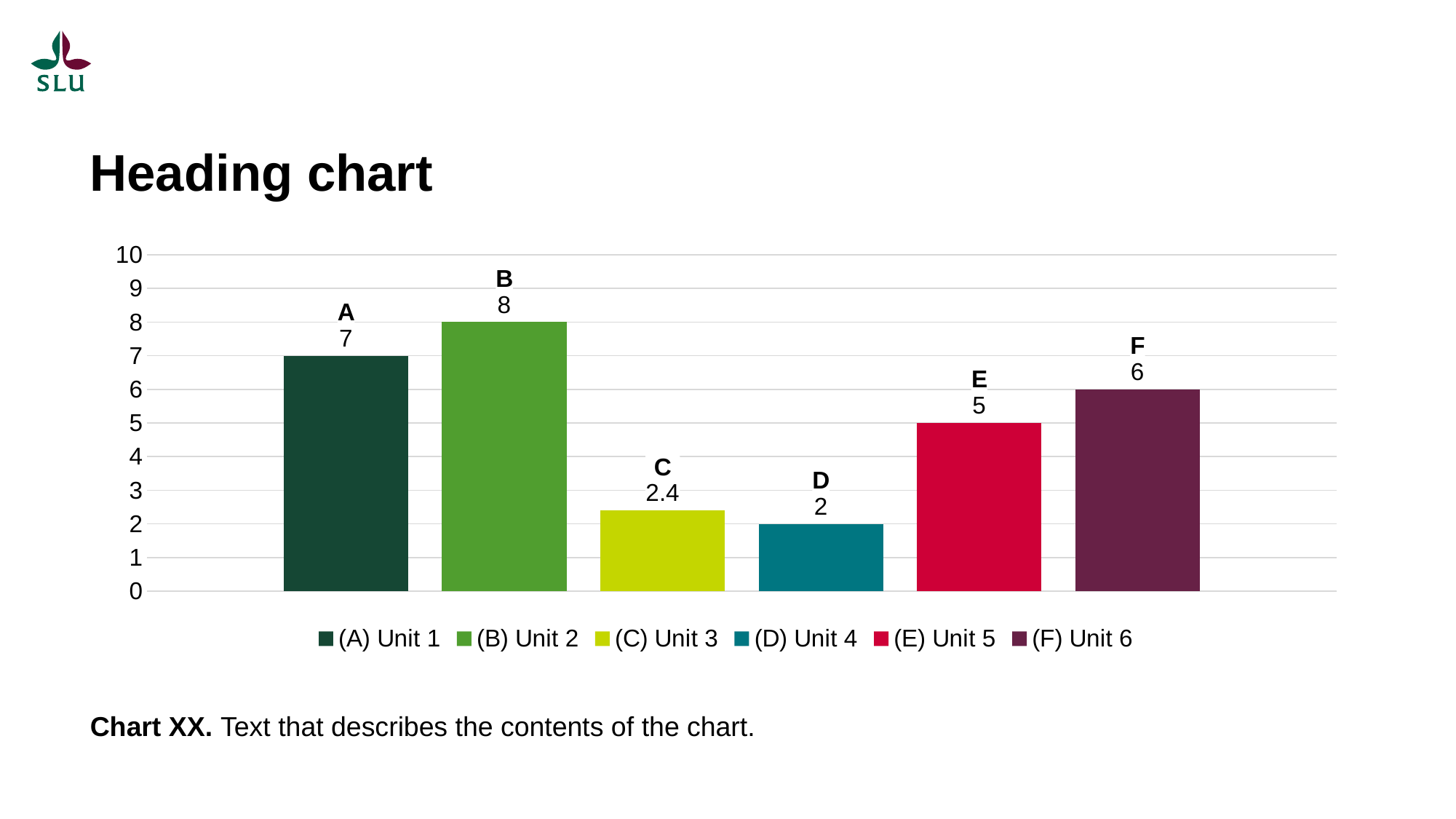
What is the legend label for the bar labelled D? (D) Unit 4 What kind of chart is shown on the slide? Bar chart How many entries does the legend list? 6 Which category has the lowest value? D Which is larger, the value for F or the value for E? F What is the difference between the values for A and D? 5 How many bars are shown in the chart? 6 What is the value for C? 2.4 Which category has the highest value? B What is the value for E? 5 What is the value for B? 8 What is the difference between the values for C and D? 0.4